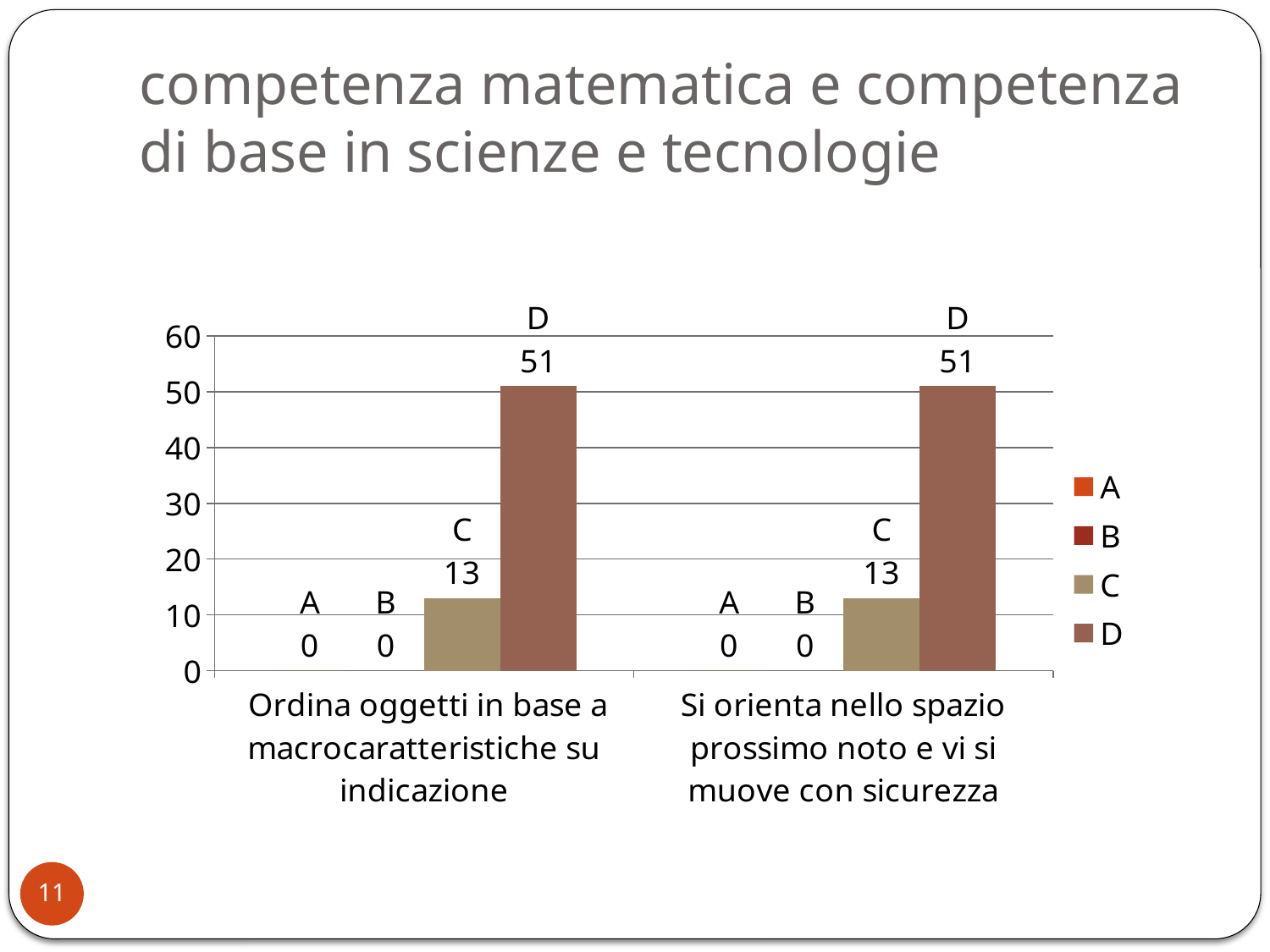
Which series has the highest value for "Ordina oggetti in base a macrocaratteristiche su indicazione"? D What is the value of series D for "Ordina oggetti in base a macrocaratteristiche su indicazione"? 51 Which is larger for "Ordina oggetti in base a macrocaratteristiche su indicazione": series C or series D? D How many categories are shown on the x axis? 2 What is the difference between series D and series C for "Si orienta nello spazio prossimo noto e vi si muove con sicurezza"? 38 What kind of chart is shown on the slide? bar chart What is the value of series B for "Si orienta nello spazio prossimo noto e vi si muove con sicurezza"? 0 What is the value of series A for "Ordina oggetti in base a macrocaratteristiche su indicazione"? 0 How many series does the legend list? 4 What is the title of the slide? competenza matematica e competenza di base in scienze e tecnologie Is the value of series D for "Si orienta nello spazio prossimo noto e vi si muove con sicurezza" greater or less than 40? greater What is the value of series C for "Si orienta nello spazio prossimo noto e vi si muove con sicurezza"? 13